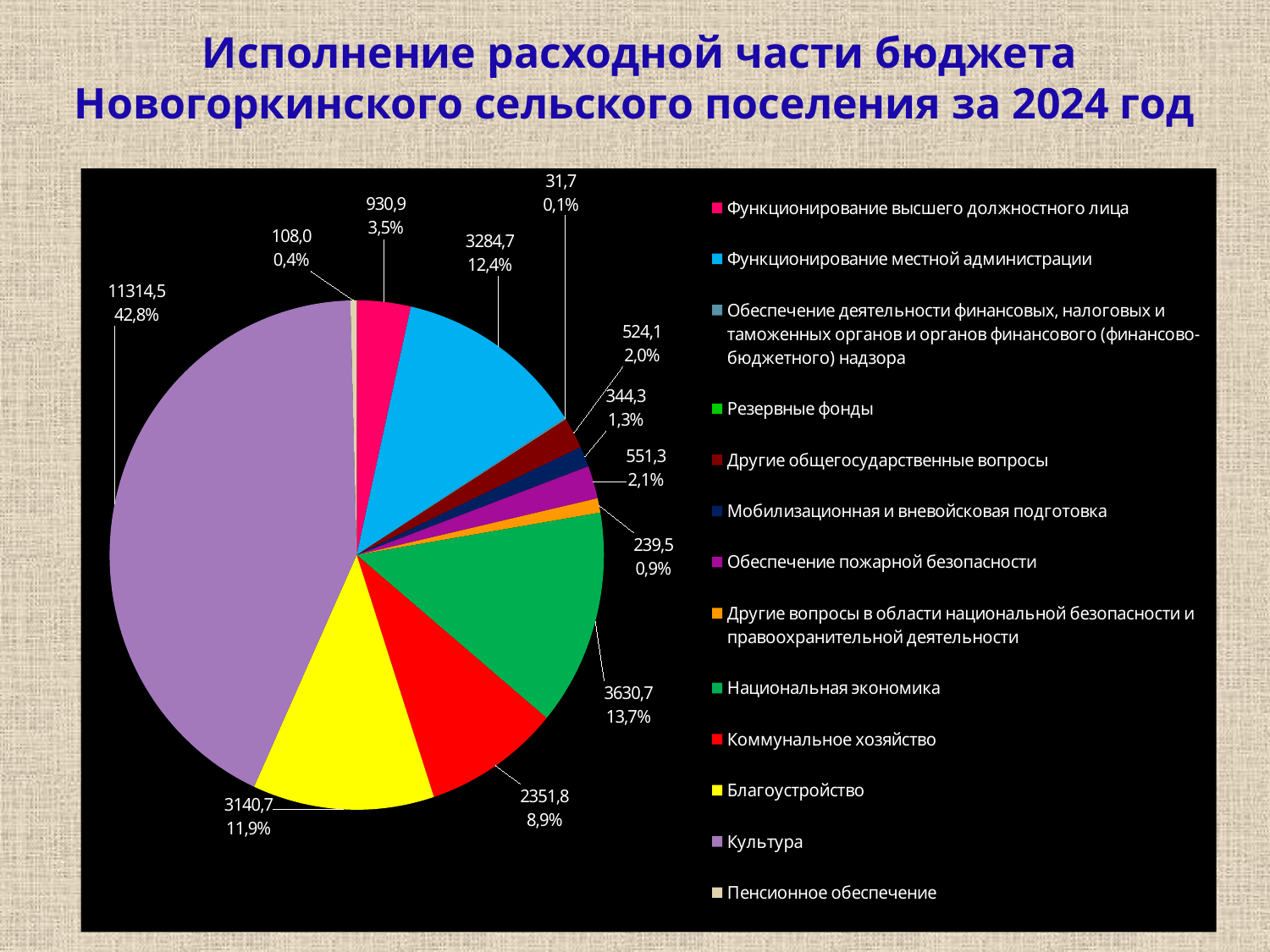
Which category has the largest slice of the pie? Культура How many entries does the legend list? 13 What share of the pie does Пенсионное обеспечение represent? 0,4% What share of the pie does Культура represent? 42,8% Which is larger, Коммунальное хозяйство or Благоустройство? Благоустройство What is the difference between the values for Национальная экономика and Коммунальное хозяйство? 1278,9 What value is shown for Благоустройство? 3140,7 What value is shown for Функционирование местной администрации? 3284,7 What value is shown for Культура? 11314,5 What kind of chart is shown on the slide? pie chart Which labelled category has the smallest slice of the pie? Обеспечение деятельности финансовых, налоговых и таможенных органов и органов финансового (финансово-бюджетного) надзора What share of the pie does Национальная экономика represent? 13,7%